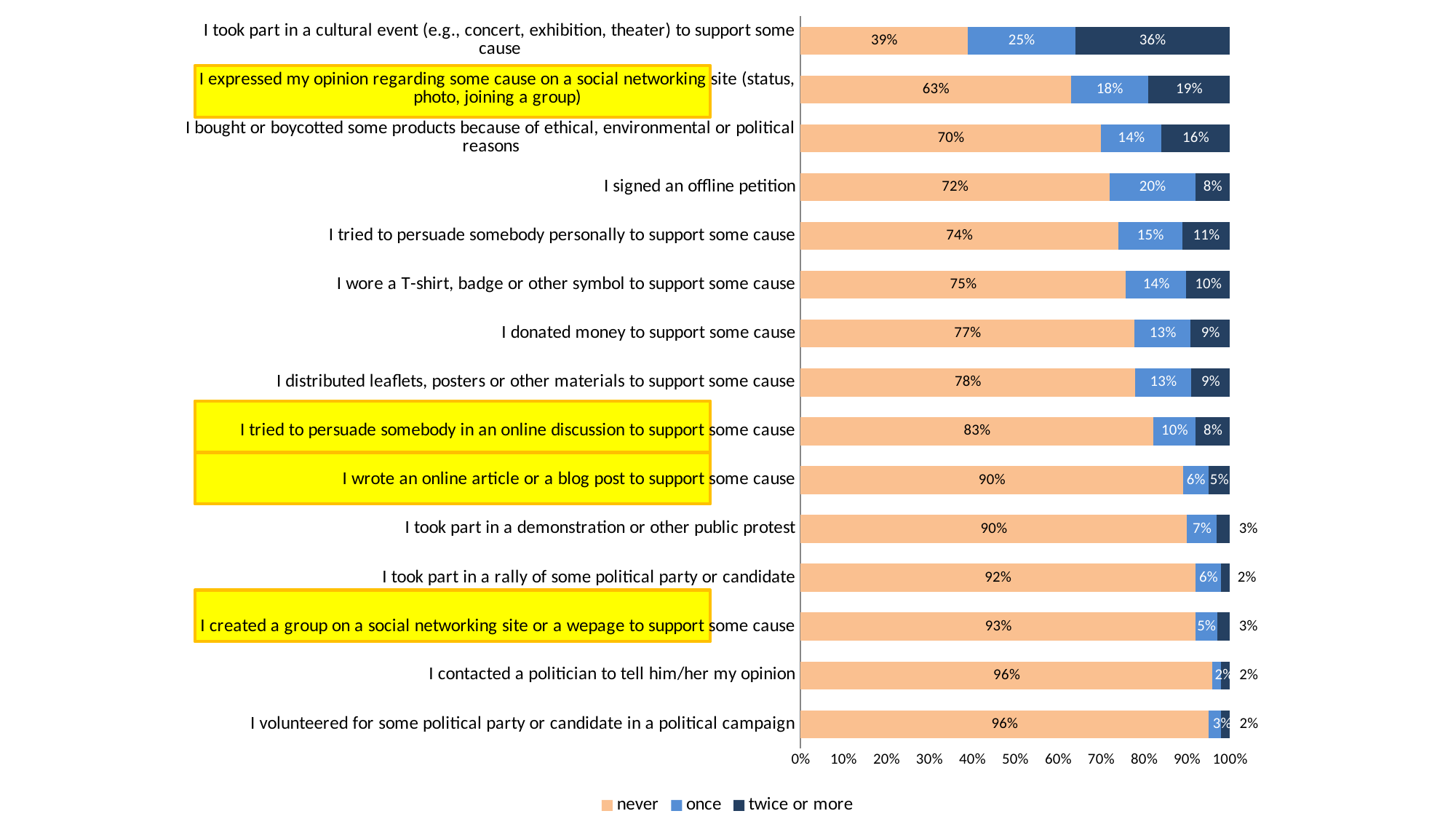
How many activity categories are plotted in the chart? 15 Which category has the lowest 'never' value? I took part in a cultural event (e.g., concert, exhibition, theater) to support some cause Which category has the highest 'once' value? I took part in a cultural event (e.g., concert, exhibition, theater) to support some cause Which is larger: the 'twice or more' value for 'I tried to persuade somebody personally to support some cause' or for 'I wore a T-shirt, badge or other symbol to support some cause'? I tried to persuade somebody personally to support some cause What is the total of the stacked bar for 'I tried to persuade somebody in an online discussion to support some cause'? 101% How many series does the legend list? 3 What is the 'once' value for 'I expressed my opinion regarding some cause on a social networking site (status, photo, joining a group)'? 18% What is the 'twice or more' value for 'I took part in a cultural event (e.g., concert, exhibition, theater) to support some cause'? 36% What kind of chart is shown on the slide? stacked bar chart What is the difference between the 'never' values for 'I bought or boycotted some products because of ethical, environmental or political reasons' and 'I donated money to support some cause'? 7% Which series is shown in the darkest colour in the legend? twice or more What is the 'never' value for 'I signed an offline petition'? 72%